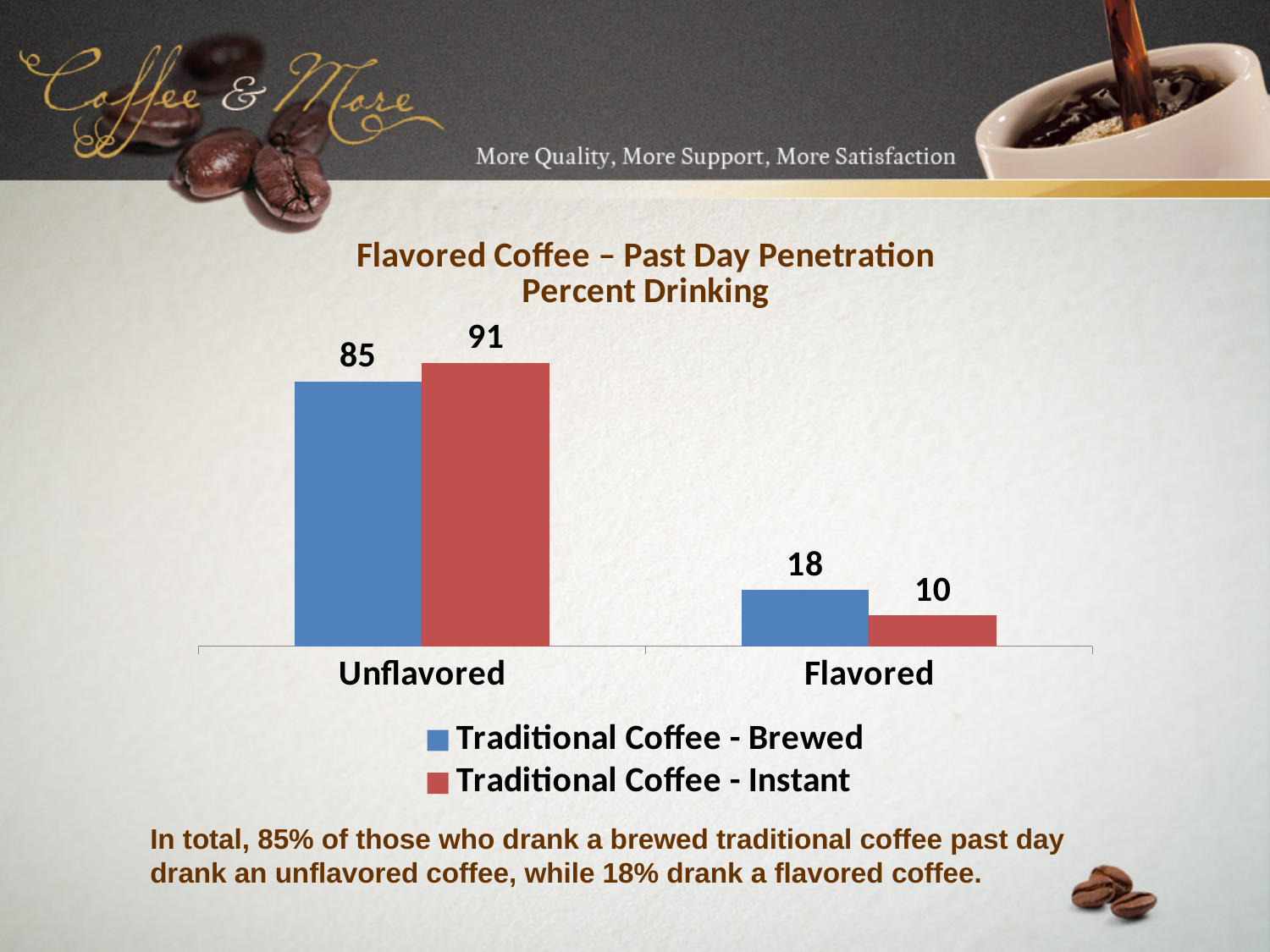
Which category has the highest value for Traditional Coffee - Instant? Unflavored How many categories are shown on the x axis? 2 What kind of chart is shown on the slide? Bar chart What is the value for Traditional Coffee - Instant in the Unflavored category? 91 What is the difference between the Traditional Coffee - Brewed and Traditional Coffee - Instant values in the Flavored category? 8 What is the difference between the Traditional Coffee - Instant and Traditional Coffee - Brewed values in the Unflavored category? 6 What is the value for Traditional Coffee - Brewed in the Unflavored category? 85 In the Flavored category, which series has the larger value, Traditional Coffee - Brewed or Traditional Coffee - Instant? Traditional Coffee - Brewed What is the value for Traditional Coffee - Instant in the Flavored category? 10 Which category has the lowest value for Traditional Coffee - Brewed? Flavored What is the value for Traditional Coffee - Brewed in the Flavored category? 18 How many series does the legend list? 2